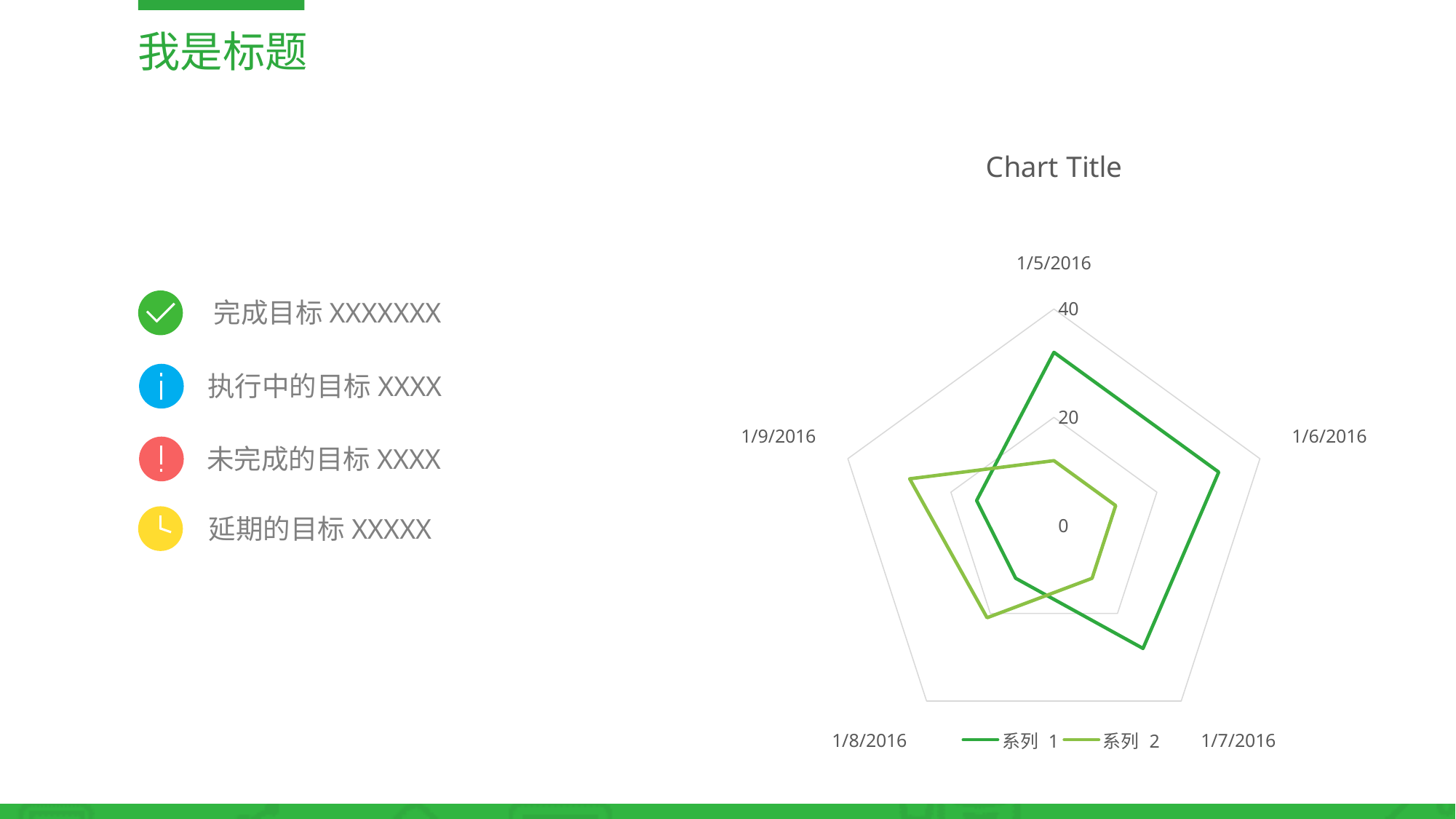
What is the title of the chart? Chart Title What kind of chart is shown on the slide? Radar chart For 1/9/2016, which series has the larger value, 系列 1 or 系列 2? 系列 2 Is the value of 系列 1 for 1/8/2016 greater or less than 20? less How many series does the legend of the chart list? 2 Is the value of 系列 2 for 1/5/2016 greater or less than 20? less Is the value of 系列 1 for 1/5/2016 greater or less than 40? less What are the two series names shown in the chart legend? 系列 1 and 系列 2 For 1/5/2016, which series has the larger value, 系列 1 or 系列 2? 系列 1 How many categories (dates) does the radar chart have? 5